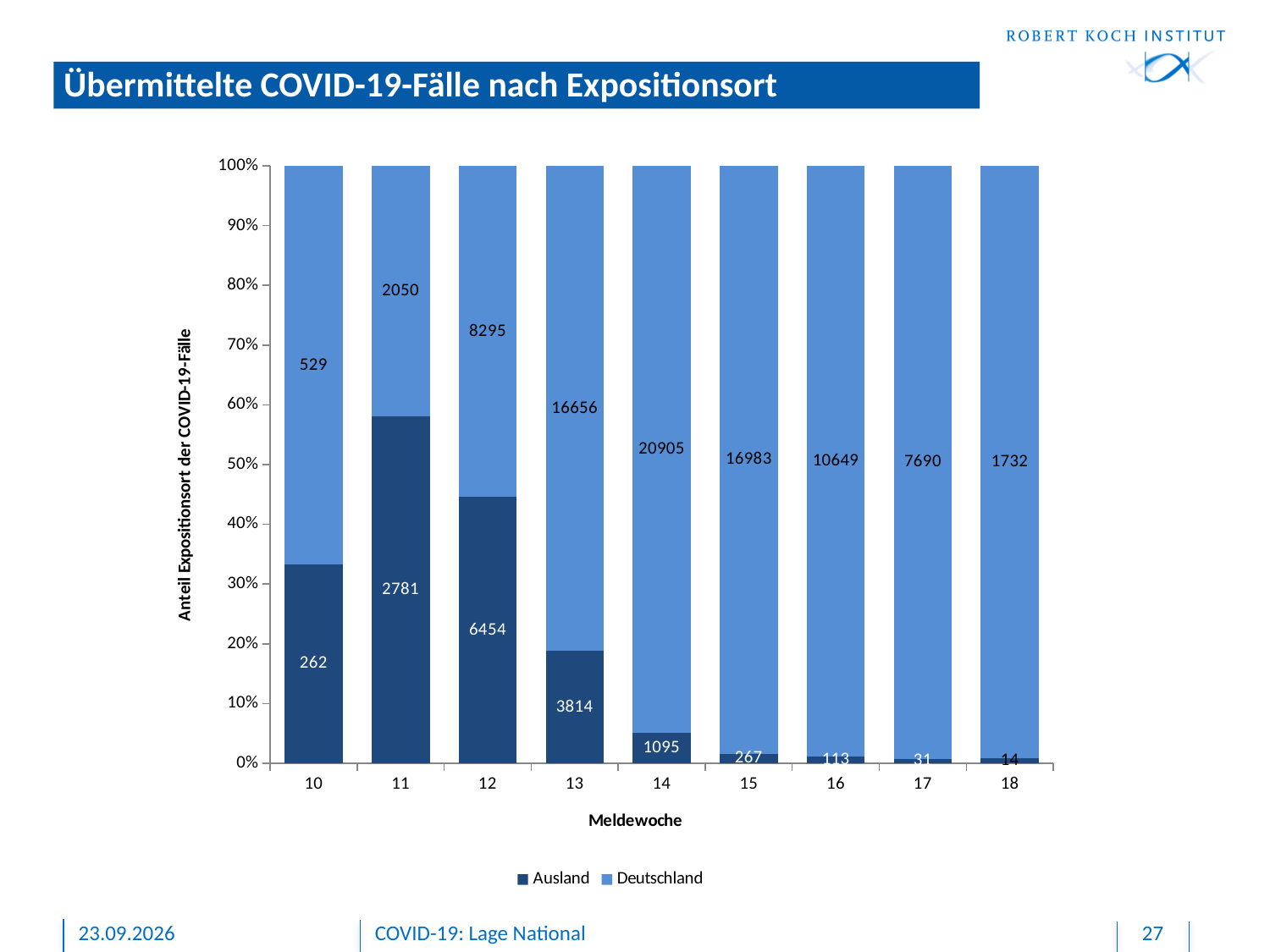
Is the Ausland share of cases in Meldewoche 11 greater or less than 50%? greater In Meldewoche 11, which series has the larger labelled value, Ausland or Deutschland? Ausland How many cases with exposure location Deutschland are labelled for Meldewoche 14? 20905 How many series does the legend list? 2 What is the total number of labelled cases (Ausland plus Deutschland) in Meldewoche 10? 791 What is the labelled number of Ausland cases in Meldewoche 12? 6454 In which Meldewoche is the labelled Ausland value the lowest? 18 Which colour represents the series Ausland in the chart? dark blue What is the difference between the Deutschland and Ausland labels in Meldewoche 13? 12842 How many Meldewochen are shown on the x axis? 9 What kind of chart is shown on the slide? stacked bar chart In which Meldewoche is the labelled Deutschland value the highest? 14